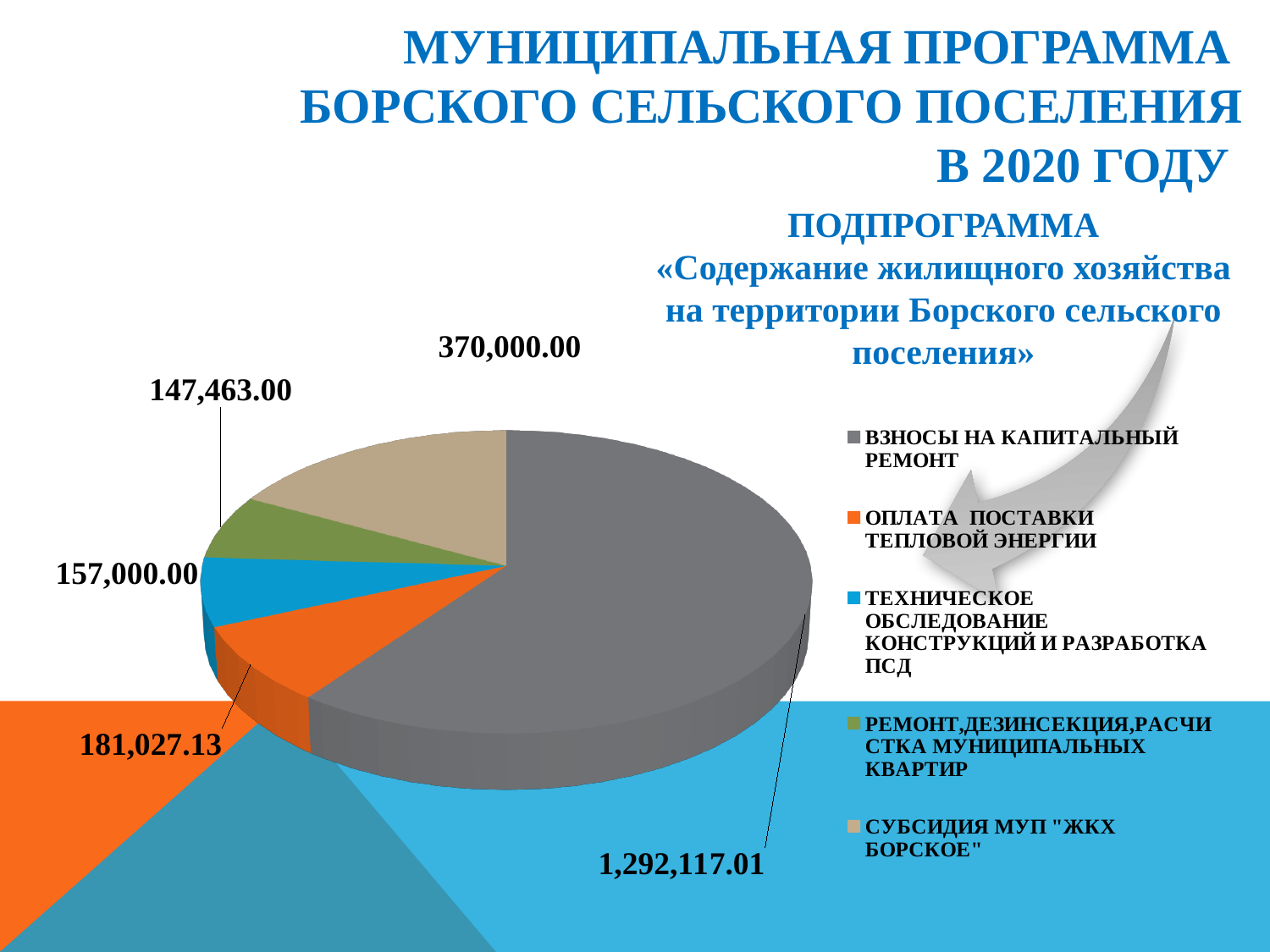
What is the value for ВЗНОСЫ НА КАПИТАЛЬНЫЙ РЕМОНТ? 1,292,117.01 What is the value for РЕМОНТ,ДЕЗИНСЕКЦИЯ,РАСЧИСТКА МУНИЦИПАЛЬНЫХ КВАРТИР? 147,463.00 What is the value for СУБСИДИЯ МУП "ЖКХ БОРСКОЕ"? 370,000.00 What colour is the slice for ТЕХНИЧЕСКОЕ ОБСЛЕДОВАНИЕ КОНСТРУКЦИЙ И РАЗРАБОТКА ПСД? Blue How many slices does the pie chart have? 5 Which is larger: the value for ОПЛАТА ПОСТАВКИ ТЕПЛОВОЙ ЭНЕРГИИ or the value for ТЕХНИЧЕСКОЕ ОБСЛЕДОВАНИЕ КОНСТРУКЦИЙ И РАЗРАБОТКА ПСД? ОПЛАТА ПОСТАВКИ ТЕПЛОВОЙ ЭНЕРГИИ What is the value for ОПЛАТА ПОСТАВКИ ТЕПЛОВОЙ ЭНЕРГИИ? 181,027.13 Which category has the smallest slice of the pie chart? РЕМОНТ,ДЕЗИНСЕКЦИЯ,РАСЧИСТКА МУНИЦИПАЛЬНЫХ КВАРТИР What type of chart is shown on the slide? Pie chart How many entries does the legend of the pie chart list? 5 Which category has the largest slice of the pie chart? ВЗНОСЫ НА КАПИТАЛЬНЫЙ РЕМОНТ What is the difference between the value for СУБСИДИЯ МУП "ЖКХ БОРСКОЕ" and the value for РЕМОНТ,ДЕЗИНСЕКЦИЯ,РАСЧИСТКА МУНИЦИПАЛЬНЫХ КВАРТИР? 222,537.00